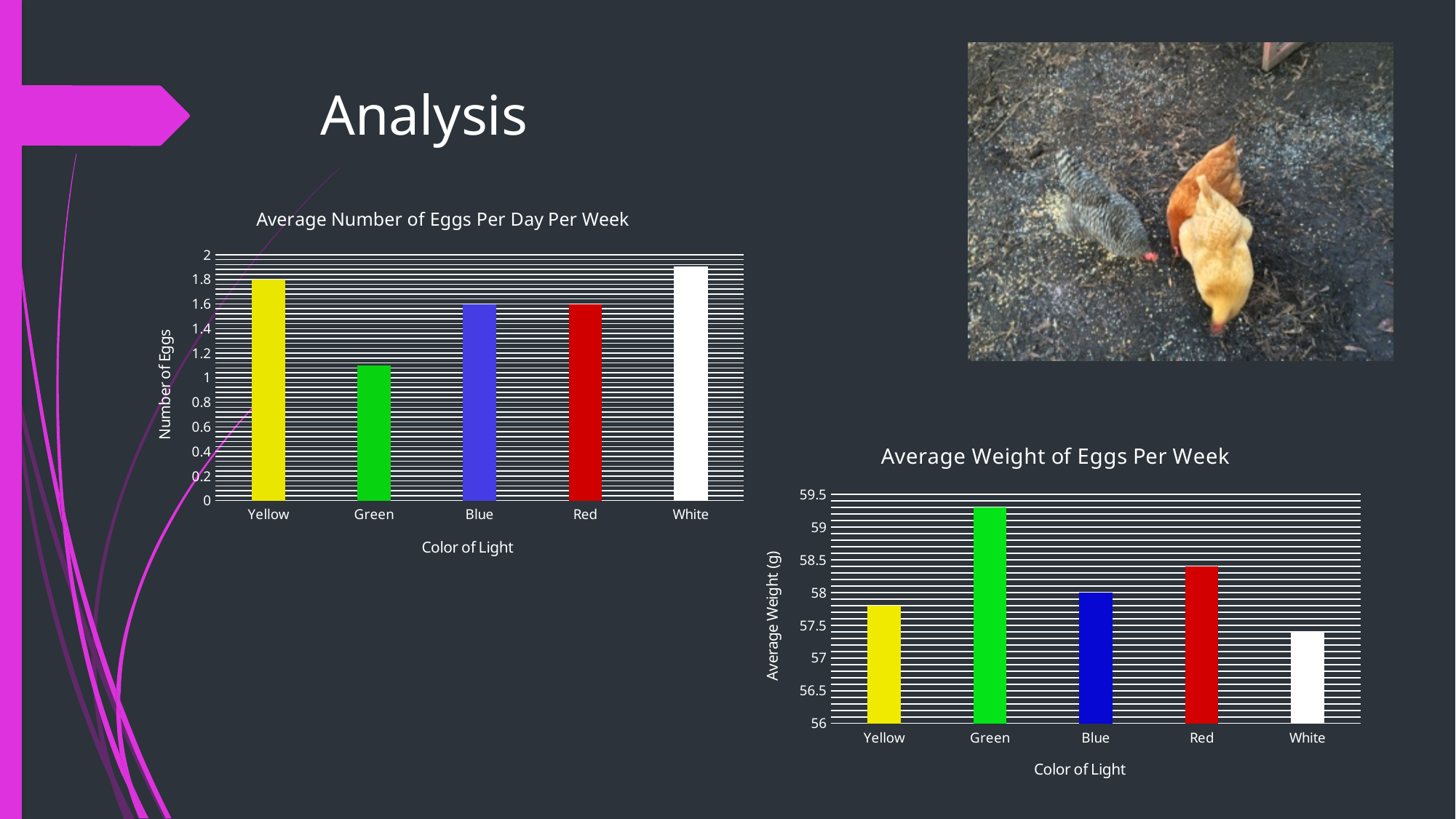
In the 'Average Number of Eggs Per Day Per Week' chart, which color of light has the lowest value? Green In the 'Average Weight of Eggs Per Week' chart, which color of light has the lowest average weight? White What type of chart is the 'Average Weight of Eggs Per Week' chart? bar chart In the 'Average Weight of Eggs Per Week' chart, which color of light has the highest average weight? Green In the 'Average Number of Eggs Per Day Per Week' chart, which is larger, the value for Yellow or the value for Green? Yellow In the 'Average Weight of Eggs Per Week' chart, which is larger, the value for Red or the value for Blue? Red In the 'Average Number of Eggs Per Day Per Week' chart, is the value for White greater or less than 1.8? greater In the 'Average Weight of Eggs Per Week' chart, is the value for Green greater or less than 59? greater In the 'Average Number of Eggs Per Day Per Week' chart, which color of light has the highest value? White How many colors of light are shown in the 'Average Number of Eggs Per Day Per Week' chart? 5 In the 'Average Number of Eggs Per Day Per Week' chart, is the value for Green greater or less than 1.2? less